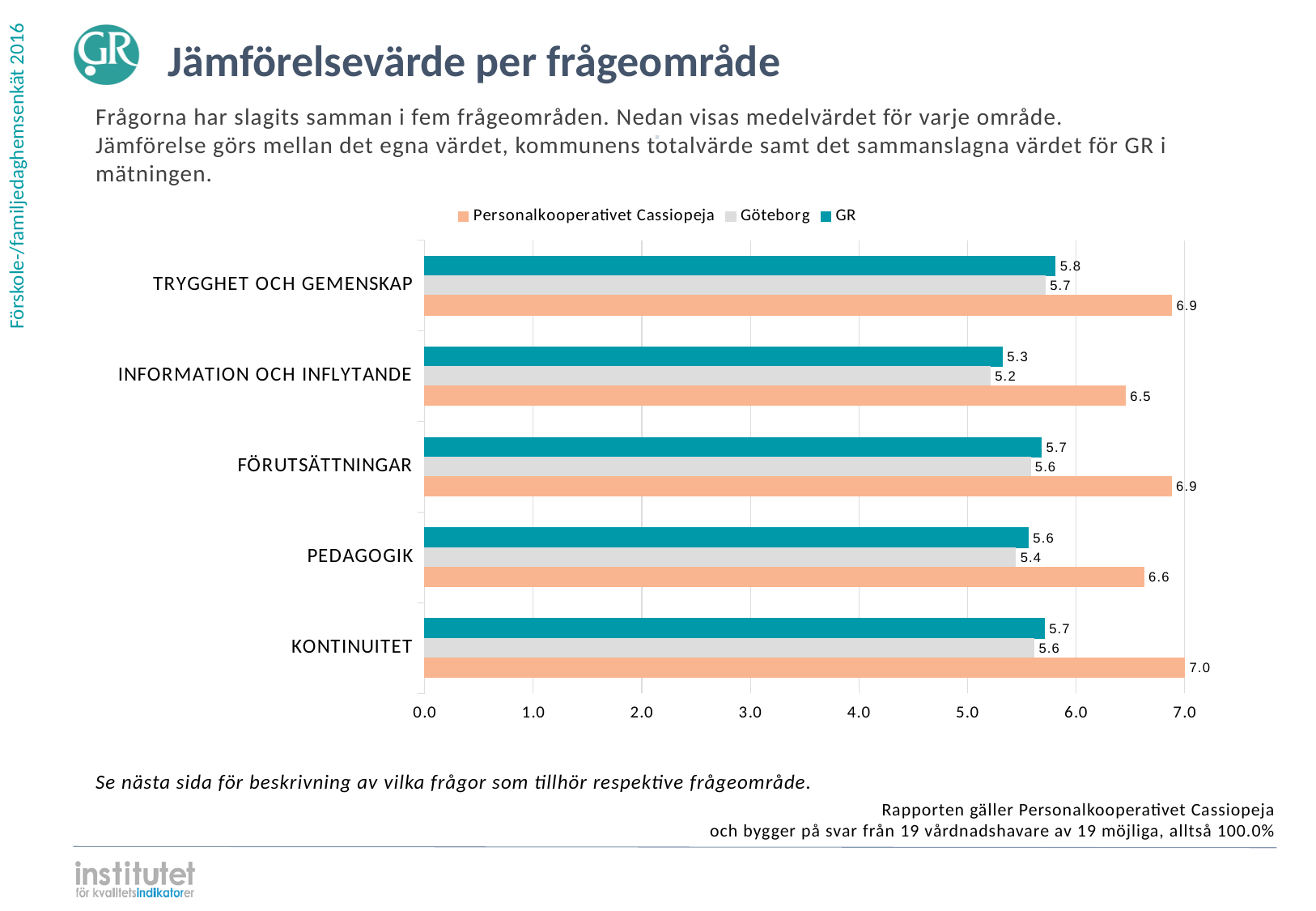
Which is larger in the PEDAGOGIK category: the GR value or the Göteborg value? GR Is the value for Personalkooperativet Cassiopeja in the INFORMATION OCH INFLYTANDE category greater or less than 6.0? greater What is the value for Göteborg in the INFORMATION OCH INFLYTANDE category? 5.2 Which category has the highest value for Personalkooperativet Cassiopeja? KONTINUITET How many series does the legend list? 3 What is the value for Personalkooperativet Cassiopeja in the KONTINUITET category? 7.0 How many categories are shown on the chart? 5 What is the value for GR in the PEDAGOGIK category? 5.6 What is the title of the slide? Jämförelsevärde per frågeområde What is the difference between the Personalkooperativet Cassiopeja value and the Göteborg value in the TRYGGHET OCH GEMENSKAP category? 1.2 Which category has the lowest value for GR? INFORMATION OCH INFLYTANDE What kind of chart is shown on the slide? Bar chart